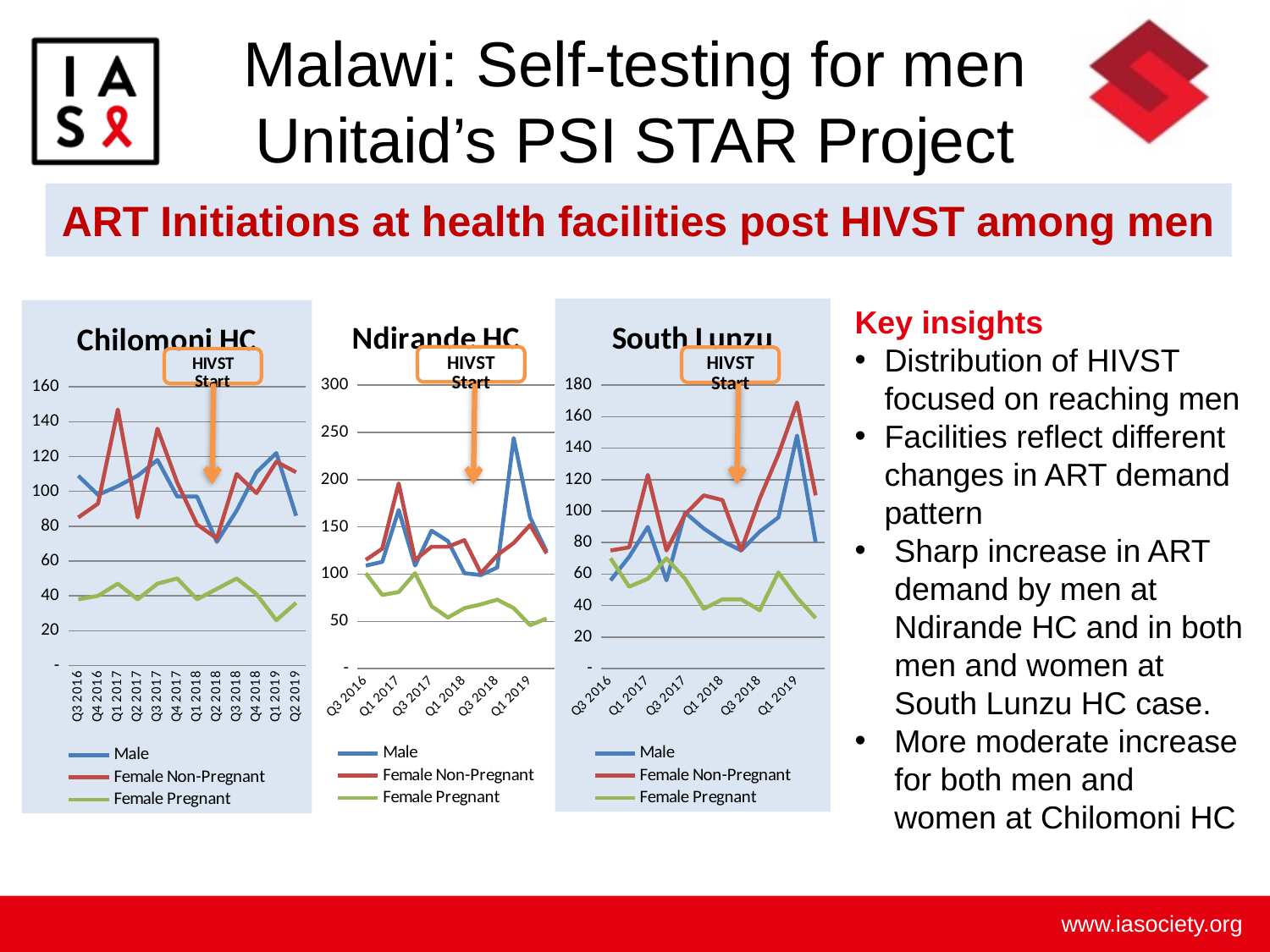
In the South Lunzu chart, which series has the lowest values across the period? Female Pregnant What are the three legend entries in the South Lunzu chart? Male, Female Non-Pregnant, Female Pregnant How many series does the legend of the Ndirande HC chart list? 3 What kind of chart is the Chilomoni HC chart? Line chart In the Chilomoni HC chart, which is larger at Q1 2017: Male or Female Non-Pregnant? Female Non-Pregnant In the Ndirande HC chart, is the Male value at Q1 2019 greater or less than 200? less In the Ndirande HC chart, does the Female Pregnant series rise or fall from Q3 2016 to Q1 2019? fall In the Chilomoni HC chart, is the Female Pregnant value at Q3 2016 greater or less than 60? less In the Ndirande HC chart, which series reaches the highest peak? Male How many quarters are labelled on the x axis of the Chilomoni HC chart? 12 What event does the orange annotation box on each chart mark? HIVST Start In the South Lunzu chart, is the Female Non-Pregnant value at Q1 2019 greater or less than 140? greater